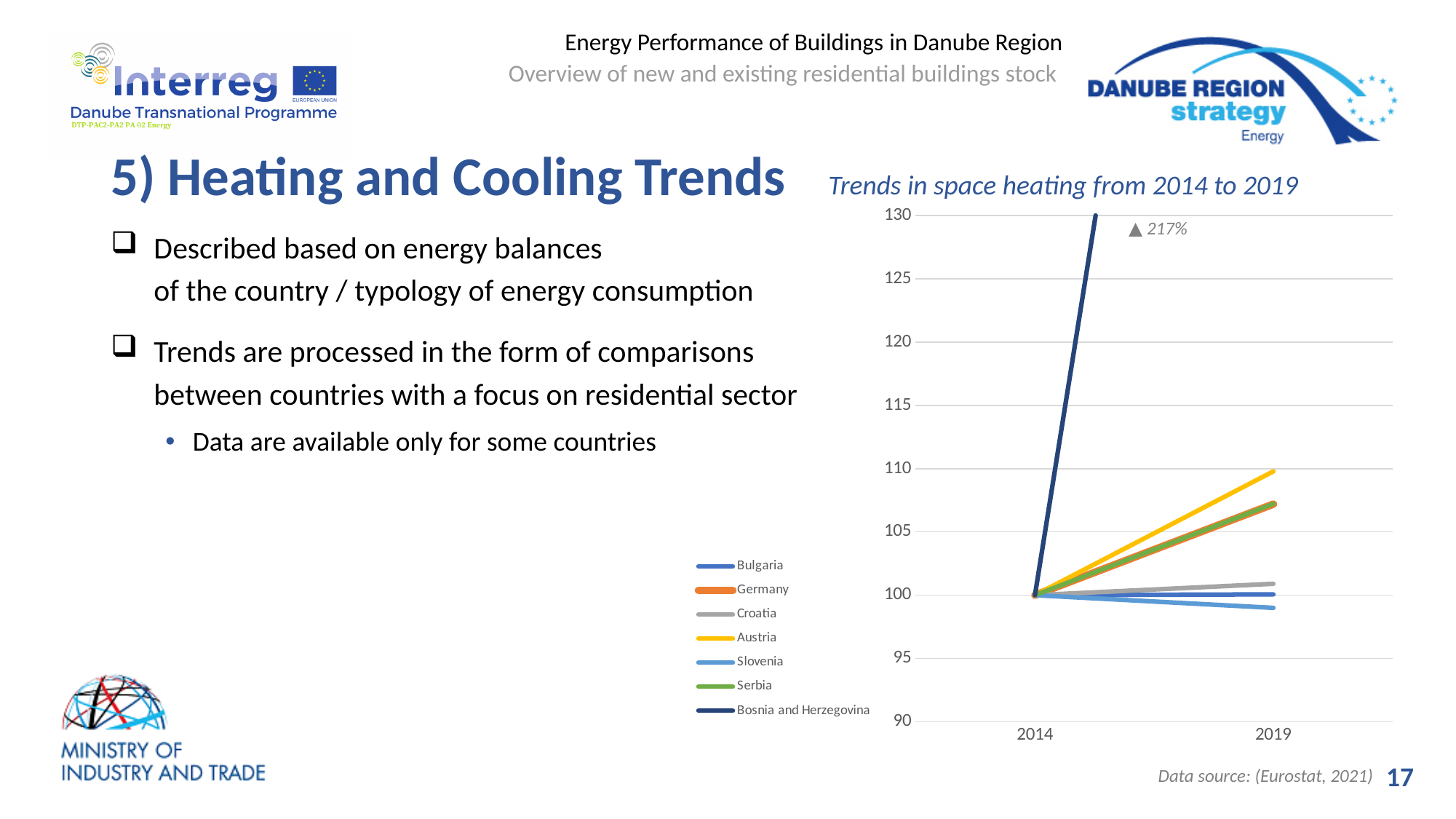
What type of chart is shown on the slide? line chart Does the line for Austria rise or fall from 2014 to 2019? rise How many series does the legend of the chart list? 7 What is the value for Austria in 2014? 100 What percentage label is shown next to the Bosnia and Herzegovina line? 217% Which country has the highest value in 2019? Bosnia and Herzegovina What is the title of the chart? Trends in space heating from 2014 to 2019 Is the value for Slovenia in 2019 greater or less than 100? less Which is larger in 2019, the value for Austria or the value for Croatia? Austria Which country has the lowest value in 2019? Slovenia How many years are shown on the x axis of the chart? 2 Is the value for Austria in 2019 greater or less than 105? greater